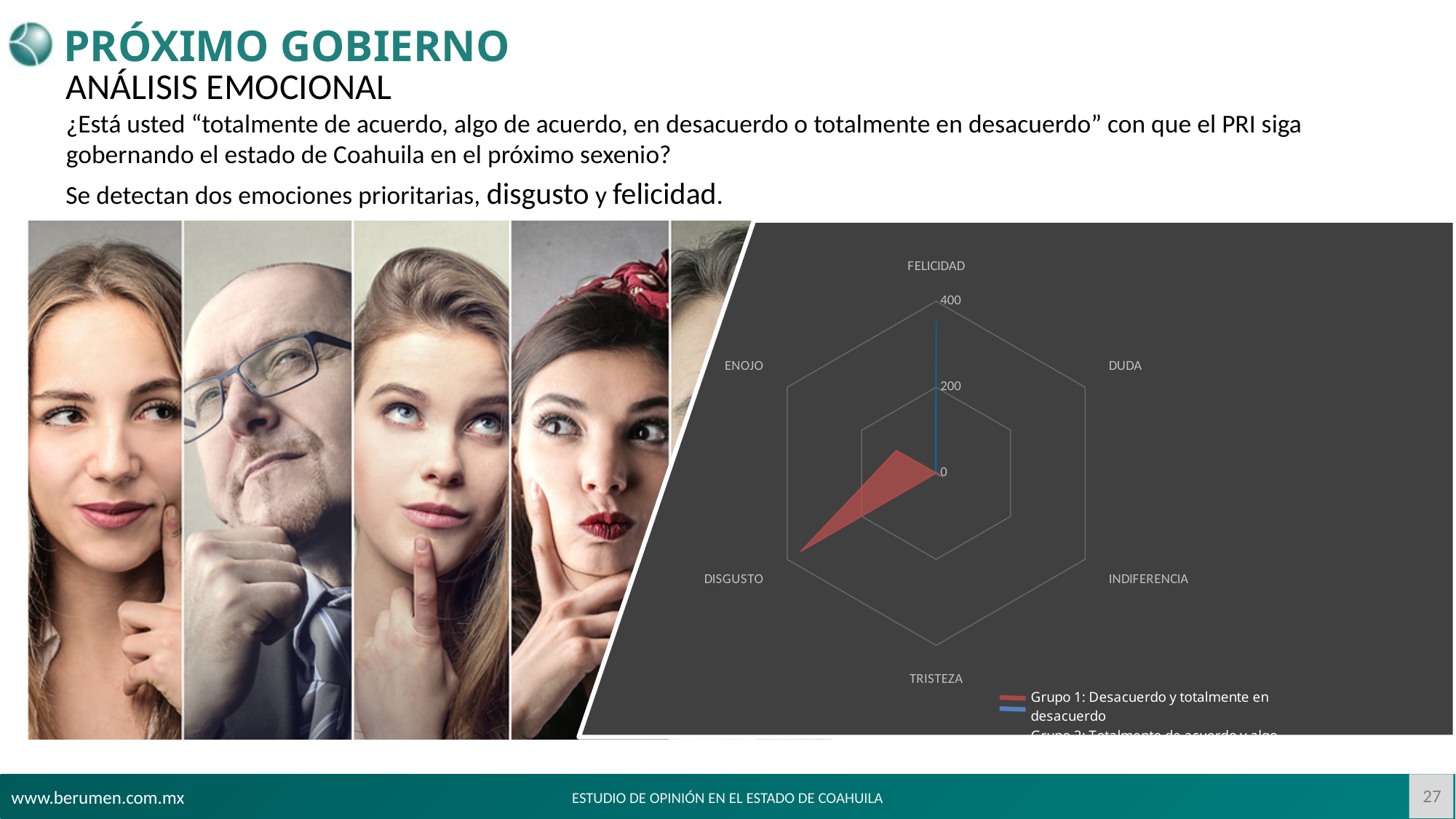
How many series does the legend of the radar chart list? 2 For the blue series (Grupo 2), which emotion has the highest value? FELICIDAD For Grupo 1, which is larger: the value at DISGUSTO or the value at FELICIDAD? DISGUSTO Which series is drawn in red on the radar chart? Grupo 1: Desacuerdo y totalmente en desacuerdo What is the maximum value shown on the radar chart's axis? 400 How many emotion categories are plotted on the radar chart? 6 For Grupo 1 (Desacuerdo y totalmente en desacuerdo), which emotion has the highest value? DISGUSTO Is the value for Grupo 1 at DISGUSTO greater or less than 200? greater Is the value for Grupo 1 at TRISTEZA greater or less than 200? less What kind of chart is shown on the slide? radar chart Is the value for the blue series (Grupo 2) at FELICIDAD greater or less than 200? greater